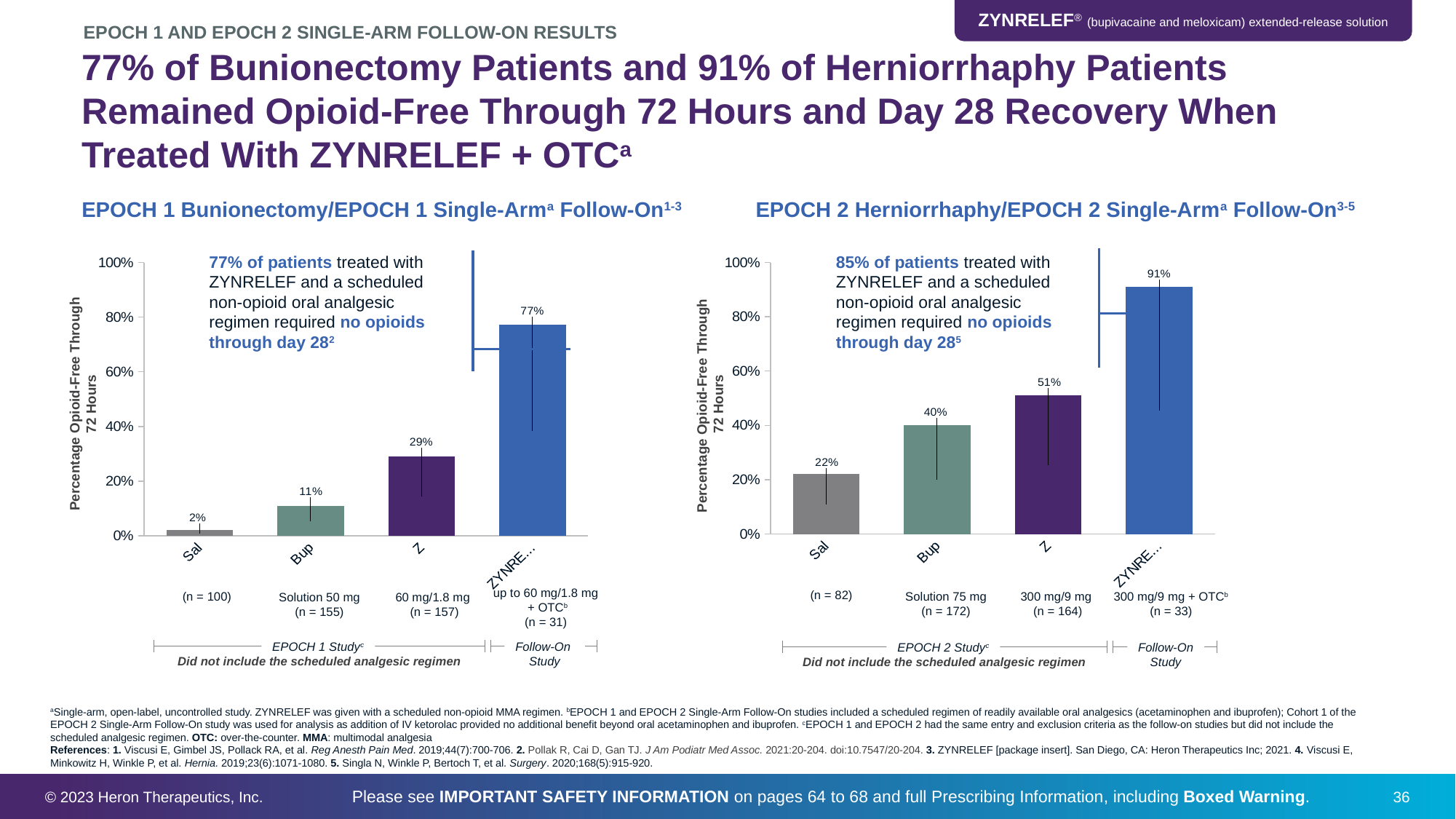
In the EPOCH 1 Bunionectomy chart on the left, what percentage is shown for the bar labelled "Bup"? 11% In the EPOCH 1 Bunionectomy chart on the left, what is the difference between the ZYNRELEF + OTC bar (77%) and the "Z" bar (29%)? 48% In the EPOCH 2 Herniorrhaphy chart on the right, which bar has the highest value? ZYNRE… (ZYNRELEF + OTC) In the EPOCH 1 Bunionectomy chart on the left, which bar has the lowest value? Sal How many bars are plotted in the EPOCH 2 Herniorrhaphy chart on the right? 4 What type of chart is used for the EPOCH 1 Bunionectomy results on the left? Bar chart In the EPOCH 2 Herniorrhaphy chart on the right, what is the difference between the "Bup" bar and the "Sal" bar? 18% Which is larger: the "Bup" value in the EPOCH 1 chart on the left or the "Bup" value in the EPOCH 2 chart on the right? EPOCH 2 (40%) In the EPOCH 2 Herniorrhaphy chart on the right, what percentage is shown for the bar labelled "Sal"? 22% In the EPOCH 2 Herniorrhaphy chart on the right, what percentage is shown for the bar labelled "Z"? 51% In the EPOCH 1 Bunionectomy chart on the left, what percentage is shown for the bar labelled "Z"? 29% In the EPOCH 1 Bunionectomy chart on the left, what percentage is shown for the bar labelled "Sal"? 2%